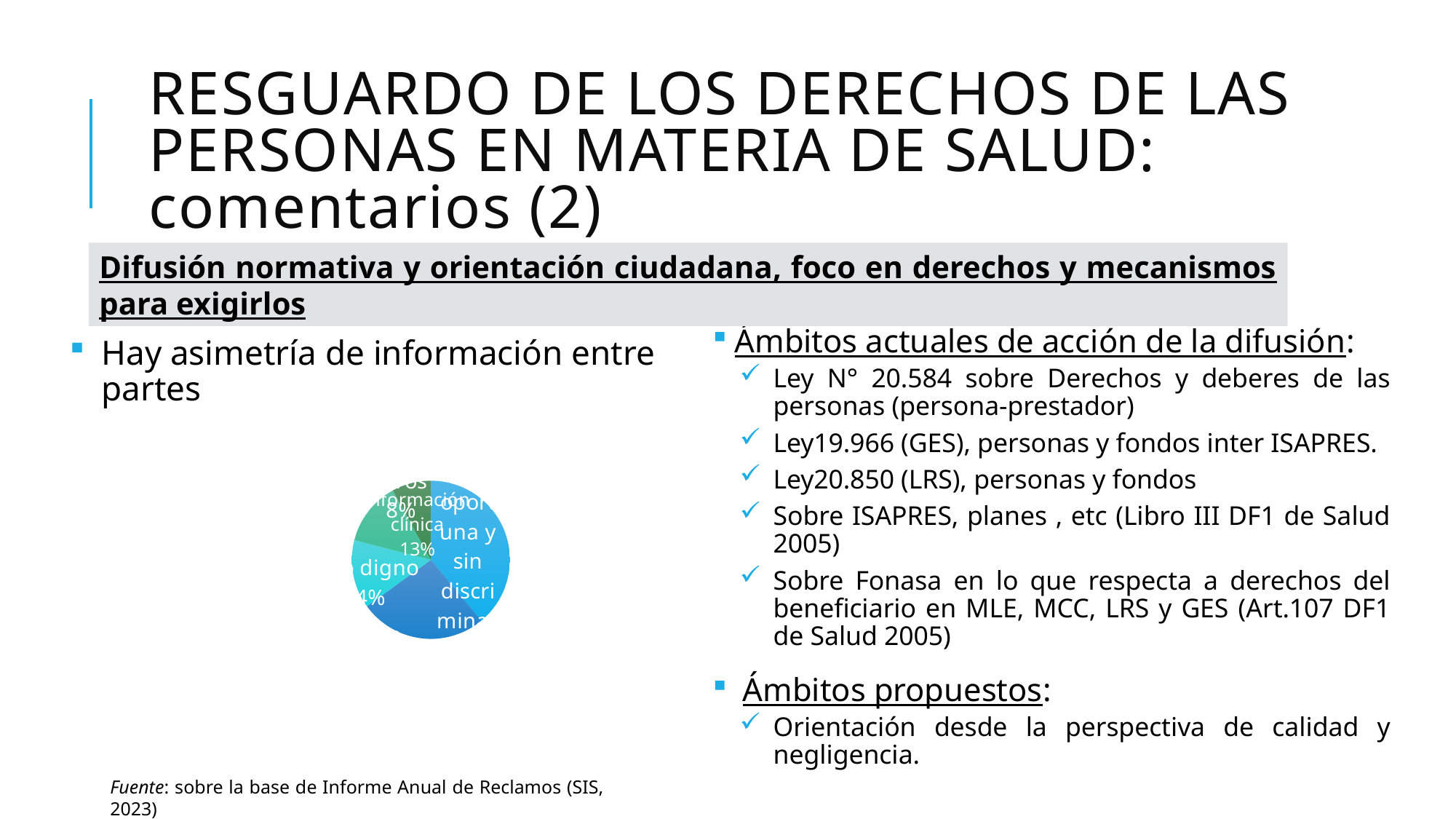
According to the note below the pie chart, what is the source of the chart data? Informe Anual de Reclamos (SIS, 2023) Which slice of the pie chart is the largest? oportuna y sin discriminación What kind of chart is shown on the left side of the slide? pie chart